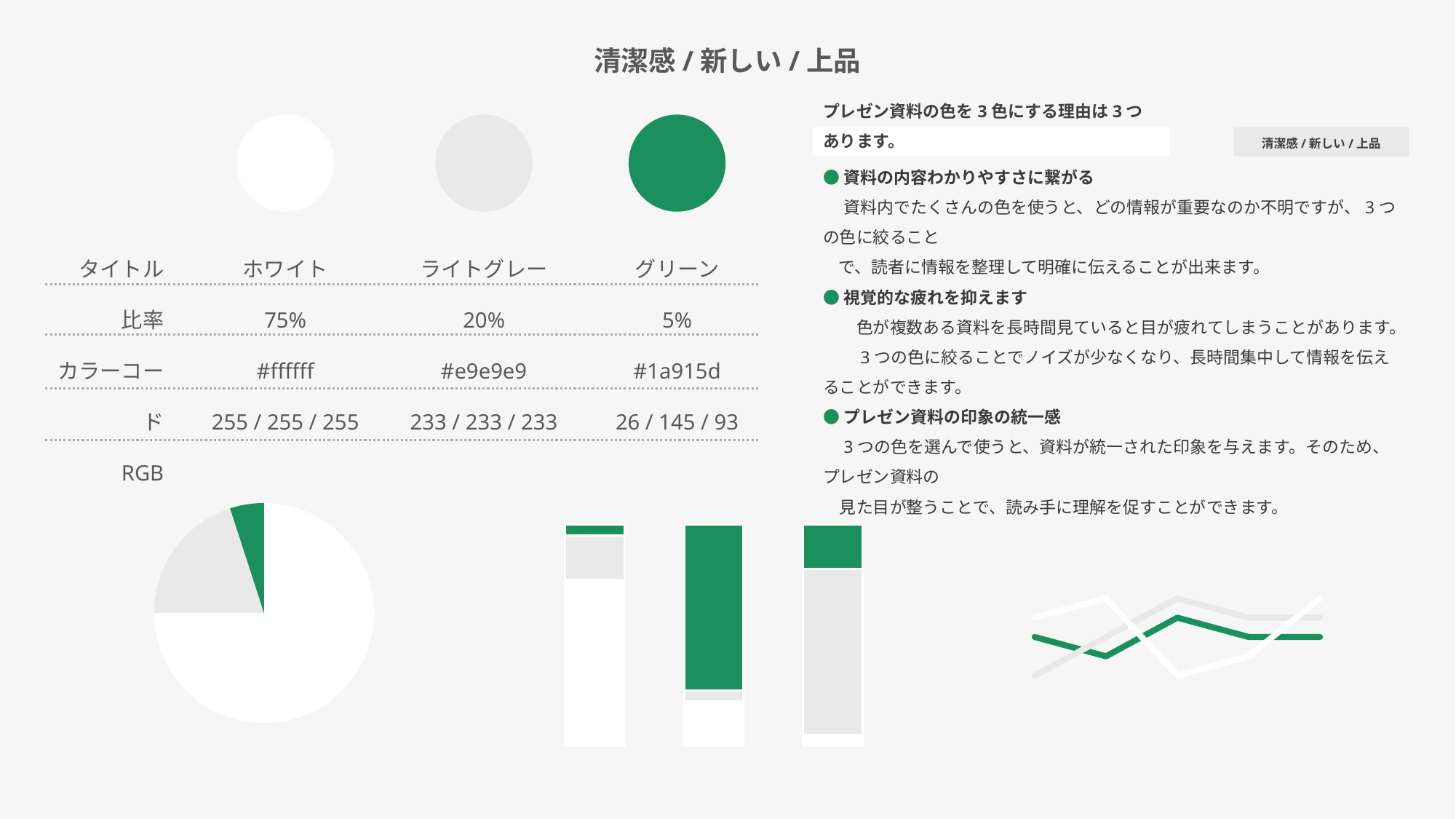
In the pie chart at the bottom left, is the white slice larger or smaller than the light grey slice? larger In the bar chart in the bottom centre, how many colour segments does each stacked bar have? 3 In the pie chart at the bottom left, how many slices are there? 3 What kind of chart is shown in the bottom centre of the slide? bar chart In the line chart at the bottom right, how many lines are plotted? 3 In the bar chart in the bottom centre, how many bars are there? 3 In the pie chart at the bottom left, which colour has the smallest slice? green In the pie chart at the bottom left, which colour has the largest slice? white What three colours are used in the charts on the slide? white, light grey, green What kind of chart is shown at the bottom left of the slide? pie chart What kind of chart is shown at the bottom right of the slide? line chart In the bar chart in the bottom centre, which bar has the largest green segment: the left, middle or right bar? middle